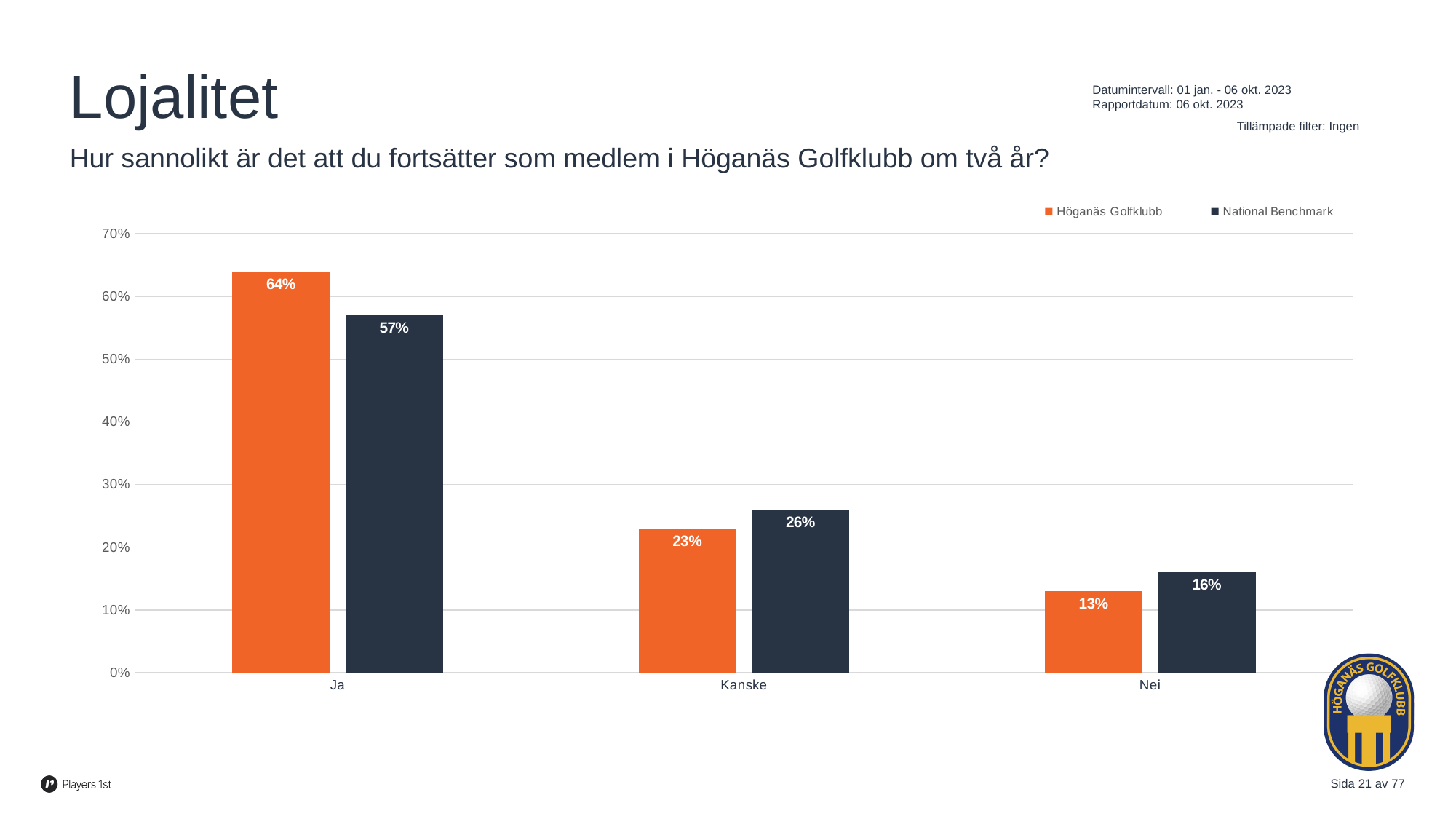
Which category has the highest value for Höganäs Golfklubb? Ja What is the difference between Höganäs Golfklubb and National Benchmark in the Ja category? 7% What is the National Benchmark value for Kanske? 26% Is the National Benchmark value for Ja greater or less than 50%? greater What is the value for Höganäs Golfklubb in the Nei category? 13% Which series is shown in orange? Höganäs Golfklubb What is the value for Höganäs Golfklubb in the Ja category? 64% How many categories are shown on the x axis? 3 Which category has the lowest value for National Benchmark? Nei How many series does the legend list? 2 Which is larger for Kanske: Höganäs Golfklubb or National Benchmark? National Benchmark What kind of chart is shown on the slide? Bar chart